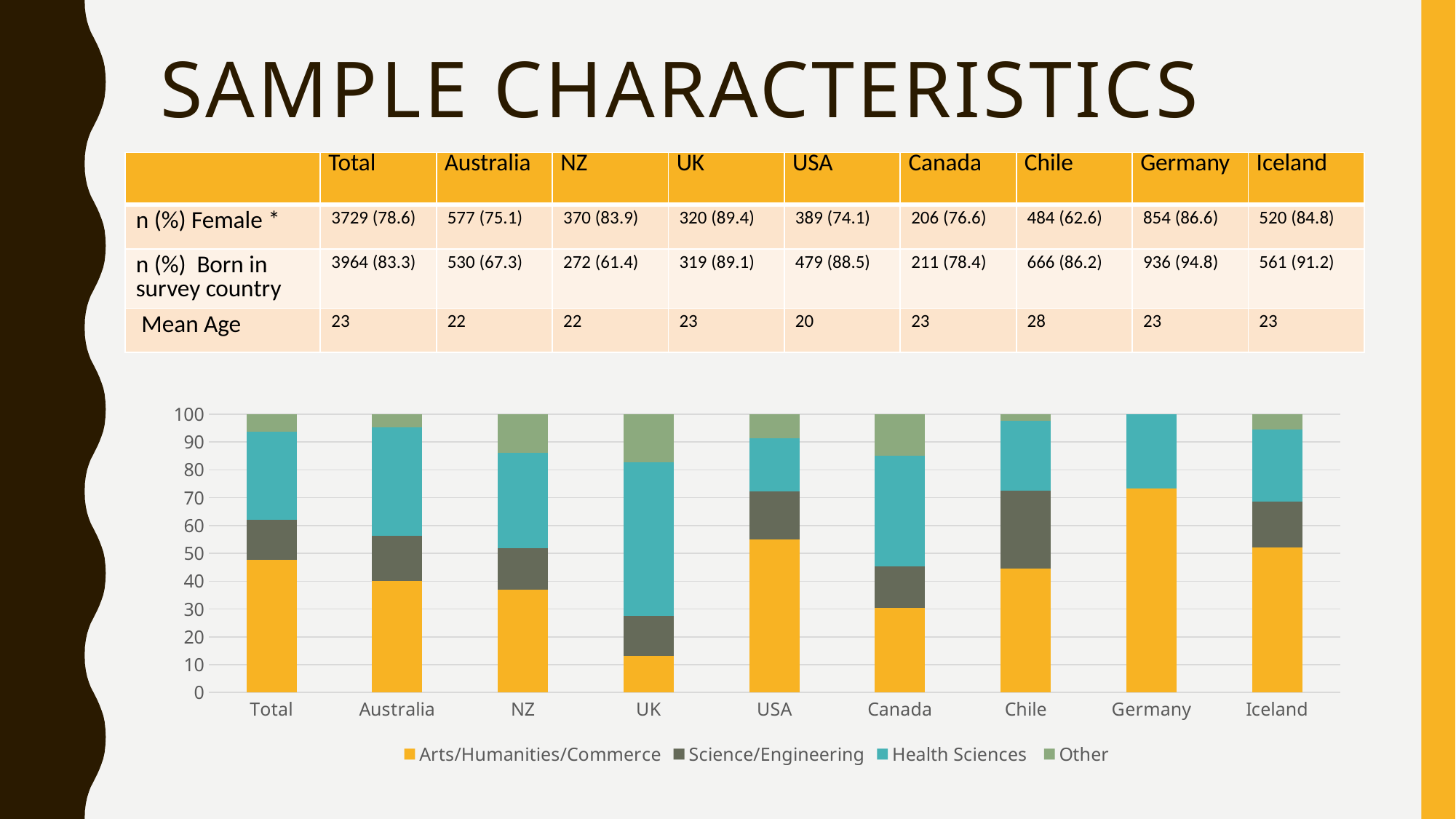
How many countries/categories are shown along the x axis of the chart? 9 Which category has the largest Science/Engineering segment? Chile Which category has the smallest Arts/Humanities/Commerce segment? UK What kind of chart is shown on the slide? stacked bar chart Is the Arts/Humanities/Commerce value for Germany greater or less than 60? greater Which category has the largest Arts/Humanities/Commerce segment? Germany Is the Arts/Humanities/Commerce value for UK greater or less than 20? less How many series does the chart legend list? 4 Which is larger, the Arts/Humanities/Commerce value for USA or for Canada? USA Is the Arts/Humanities/Commerce value for Canada greater or less than 40? less Which category has the largest Health Sciences segment? UK Which series is shown in the yellow/orange colour at the bottom of each bar? Arts/Humanities/Commerce